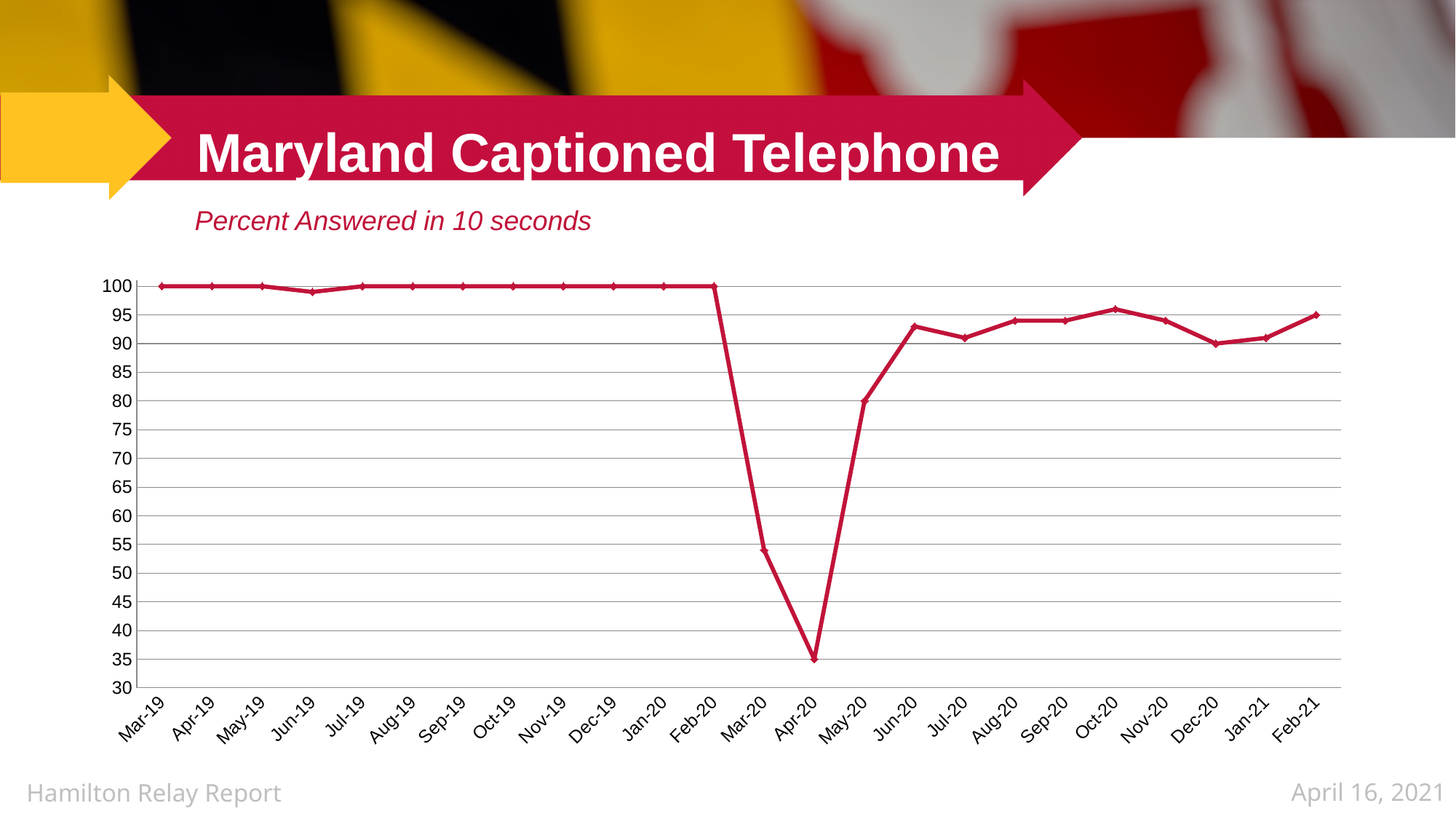
How many months are plotted on the x axis? 24 What is the value for Apr-20? 35 What kind of chart is shown on the slide? Line chart Do the values rise or fall from Feb-20 to Apr-20? fall What is the value for Mar-19? 100 What is the value for May-20? 80 Which is larger, the value for Apr-20 or the value for May-20? May-20 What is the difference between the values for May-20 and Apr-20? 45 Which month has the lowest percent answered in 10 seconds? Apr-20 Is the value for Mar-20 greater or less than 60? less What does the subtitle say the chart measures? Percent Answered in 10 seconds What is the title of the chart on the slide? Maryland Captioned Telephone